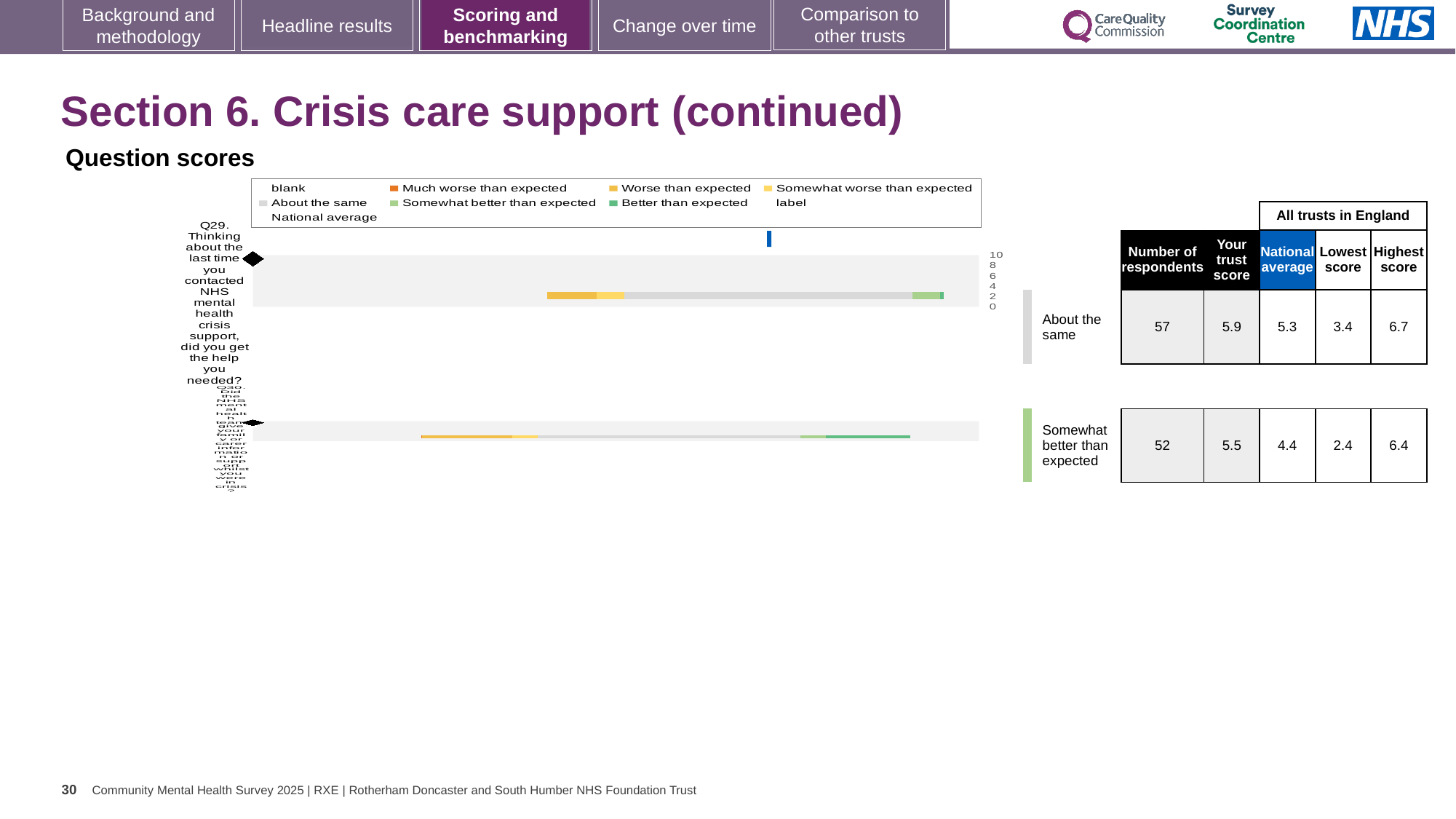
What is the trust score for Q29? 5.9 What is the difference between the trust score and the national average for Q30? 1.1 What is the difference in the number of respondents between Q29 and Q30? 5 What kind of chart is shown under 'Question scores'? bar chart How many questions (bars) are plotted in the chart? 2 What benchmark category is Q30 assigned to? Somewhat better than expected What is the highest score across all trusts in England for Q30? 6.4 Which question has the higher trust score, Q29 or Q30? Q29 What is the national average for Q29? 5.3 What is the trust score for Q30? 5.5 What is the lowest score across all trusts in England for Q29? 3.4 What is the number of respondents for Q30? 52